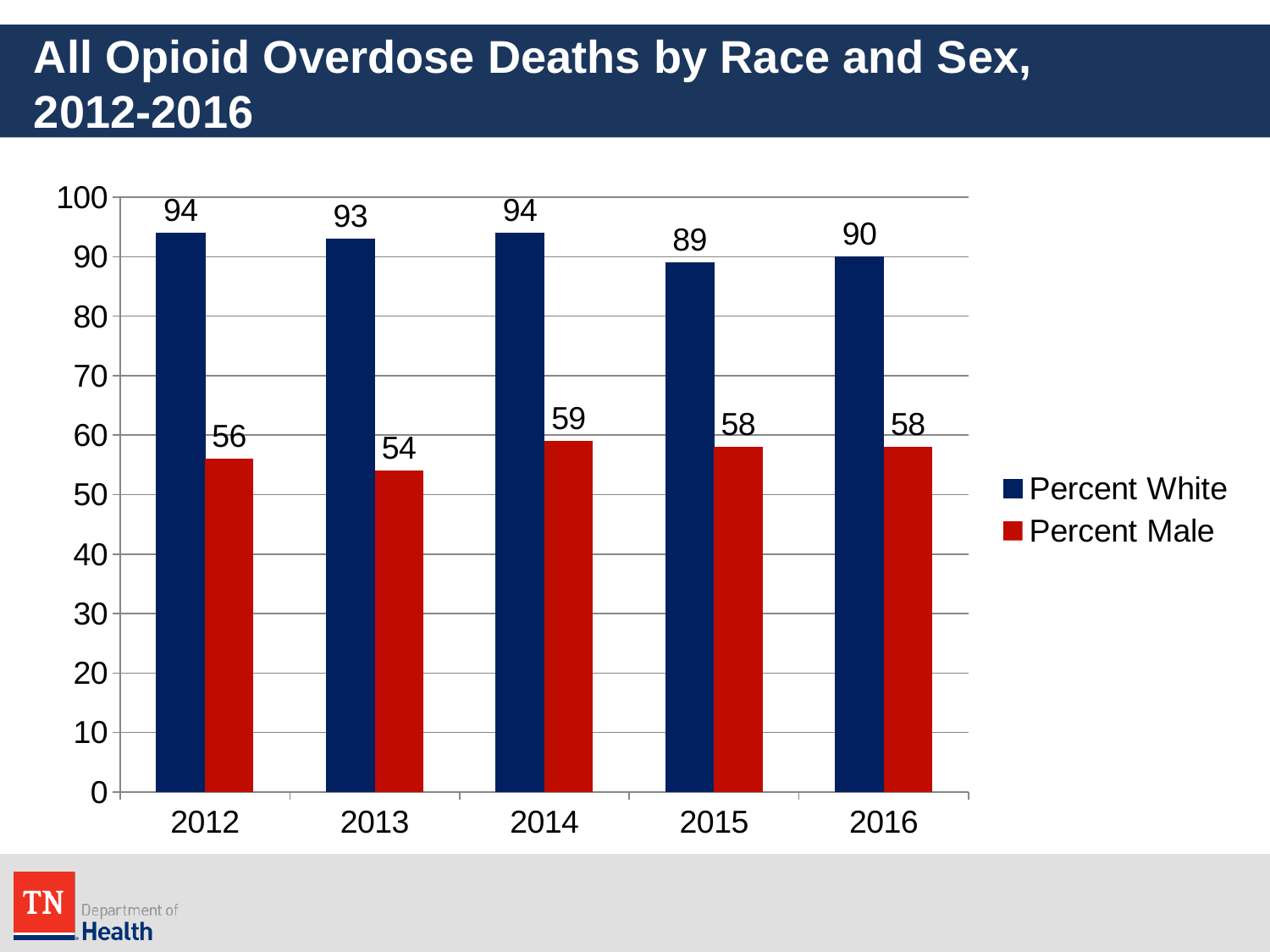
What is the Percent Male value for 2013? 54 What is the difference between the Percent White values for 2014 and 2016? 4 Which year has the lowest Percent Male value? 2013 What is the Percent Male value for 2014? 59 What kind of chart is shown on the slide? Bar chart What is the Percent White value for 2015? 89 Which year has the lowest Percent White value? 2015 Which is larger, the Percent Male value for 2014 or for 2013? 2014 Which colour represents Percent Male in the chart? Red How many years are shown on the x axis? 5 What is the difference between Percent White and Percent Male in 2012? 38 How many series does the legend list? 2